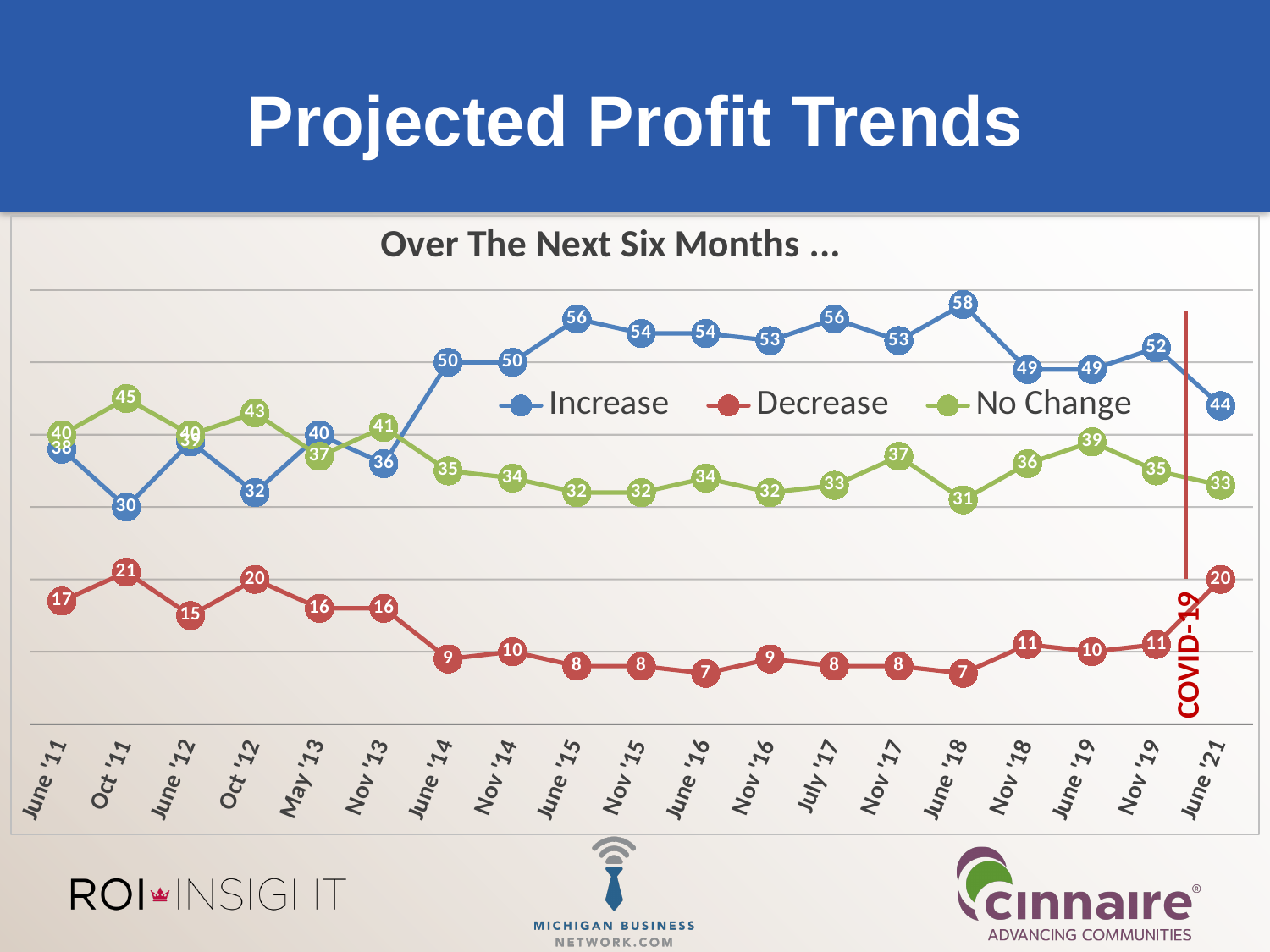
At Oct '11, which series has the larger value, Increase or No Change? No Change What is the value of the Increase series at June '18? 58 What is the difference between the Increase values at Nov '19 and June '21? 8 What label is written next to the vertical red line near the right of the chart? COVID-19 At which time point is the Increase series at its lowest value? Oct '11 At which time point does the Increase series reach its highest value? June '18 What is the value of the Decrease series at June '21? 20 How many series does the legend list? 3 How many time points are plotted along the x axis? 19 What is the value of the No Change series at Oct '11? 45 What kind of chart is shown on the slide? line chart Does the Increase series rise or fall from Nov '19 to June '21? fall